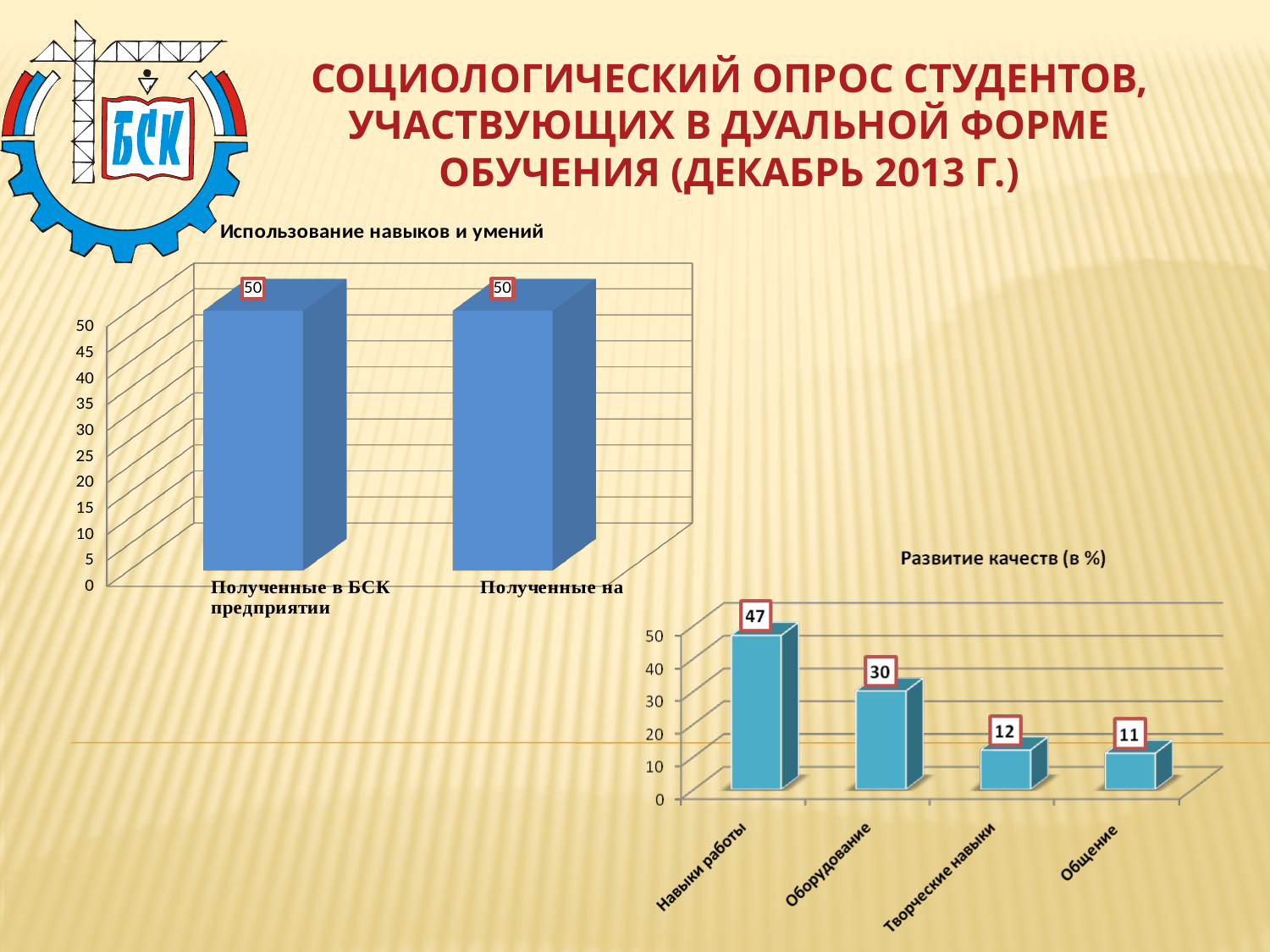
In the chart 'Развитие качеств (в %)', how many categories are shown? 4 In the chart 'Развитие качеств (в %)', which category has the highest value? Навыки работы In the chart 'Развитие качеств (в %)', what is the value for 'Оборудование'? 30 In the chart 'Развитие качеств (в %)', what is the value for 'Навыки работы'? 47 In the chart 'Развитие качеств (в %)', which category has the lowest value? Общение In the chart 'Развитие качеств (в %)', what is the difference between 'Навыки работы' and 'Оборудование'? 17 In the chart 'Развитие качеств (в %)', what is the value for 'Общение'? 11 In the chart 'Использование навыков и умений', how many bars are plotted? 2 What kind of chart is 'Использование навыков и умений'? bar chart In the chart 'Использование навыков и умений', what is the value for 'Полученные в БСК предприятии'? 50 In the chart 'Развитие качеств (в %)', do the values rise or fall from left to right? fall In the chart 'Использование навыков и умений', what is the value for 'Полученные на'? 50